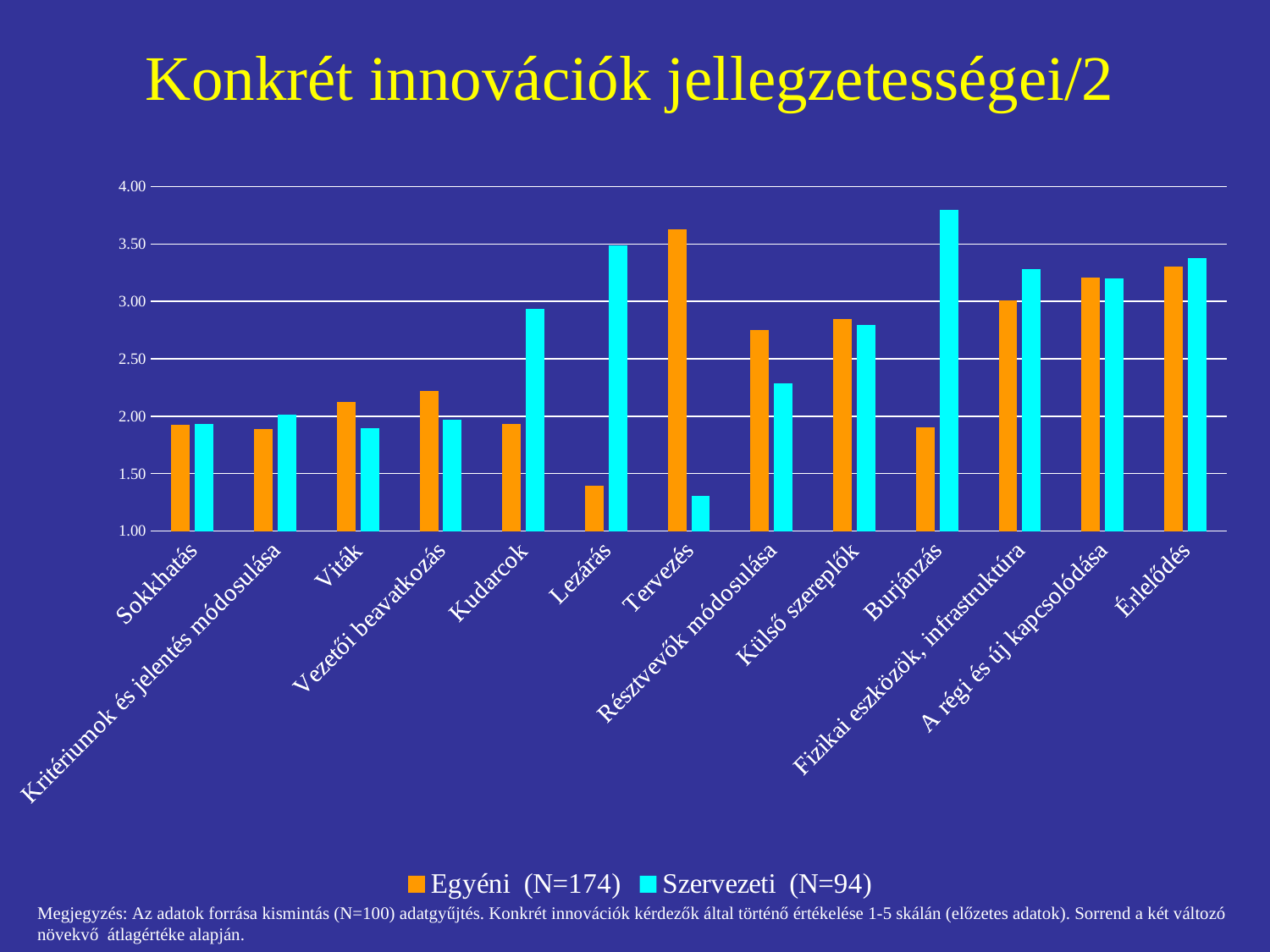
Is the Egyéni (N=174) value for Burjánzás greater or less than 2.00? less Which category has the lowest Egyéni (N=174) value? Lezárás How many series does the legend list? 2 What is the title of the slide? Konkrét innovációk jellegzetességei/2 Which category has the highest Egyéni (N=174) value? Tervezés How many categories are shown on the x axis? 13 Is the Egyéni (N=174) value for Tervezés greater or less than 3.50? greater Which category has the lowest Szervezeti (N=94) value? Tervezés Which category has the highest Szervezeti (N=94) value? Burjánzás What kind of chart is shown on the slide? bar chart Is the Szervezeti (N=94) value for Kudarcok greater or less than 3.00? less For Lezárás, which series has the larger value, Egyéni (N=174) or Szervezeti (N=94)? Szervezeti (N=94)